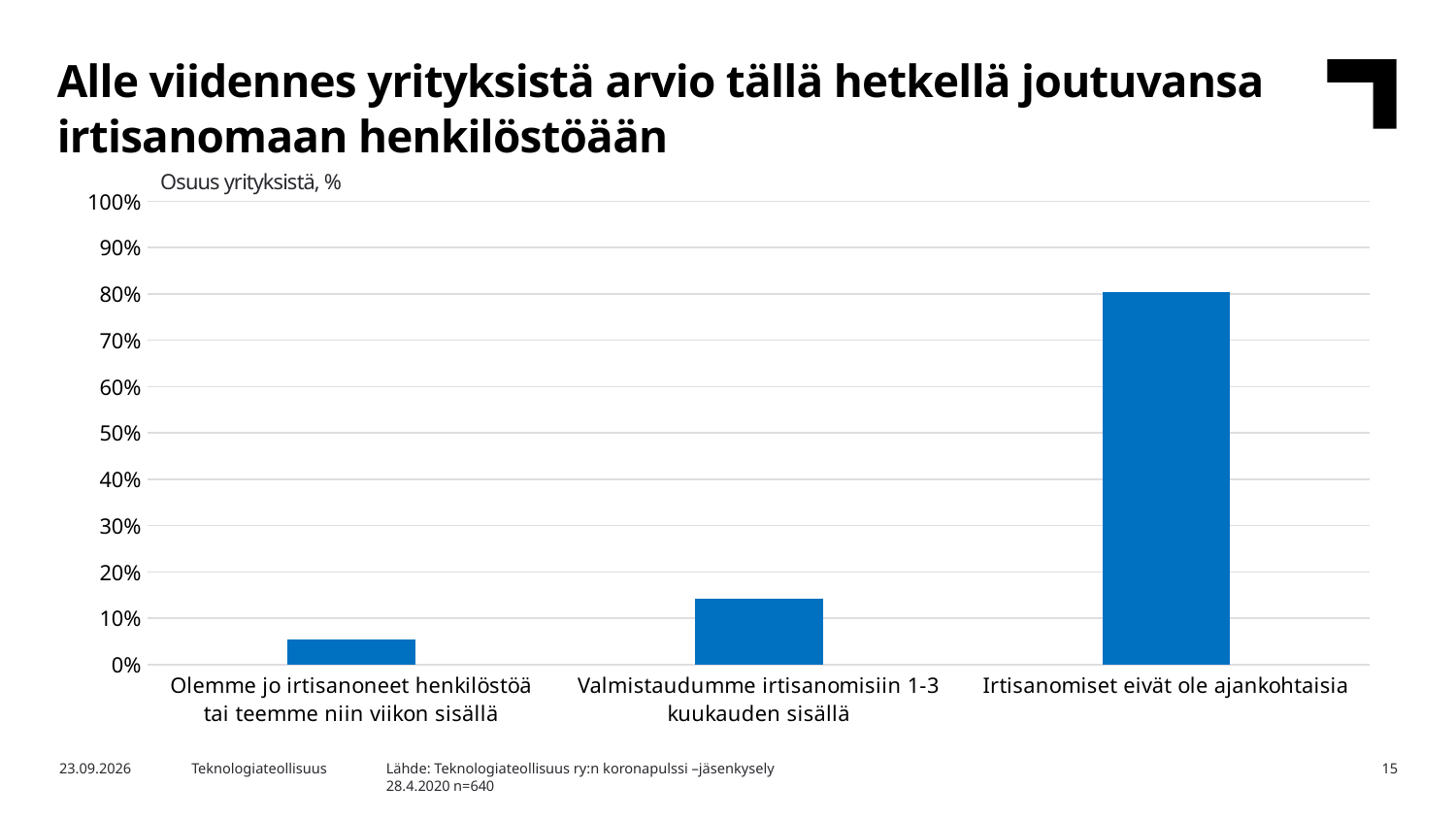
Which category has the highest value in the chart? Irtisanomiset eivät ole ajankohtaisia What is the label of the vertical axis of the chart? Osuus yrityksistä, % Is the value for 'Valmistaudumme irtisanomisiin 1-3 kuukauden sisällä' greater or less than 10%? greater What is the maximum value shown on the vertical axis of the chart? 100% How many categories are shown on the x axis of the chart? 3 What kind of chart is shown on the slide? bar chart Which category has the lowest value in the chart? Olemme jo irtisanoneet henkilöstöä tai teemme niin viikon sisällä Is the value for 'Valmistaudumme irtisanomisiin 1-3 kuukauden sisällä' greater or less than 20%? less Is the value for 'Irtisanomiset eivät ole ajankohtaisia' greater or less than 70%? greater Which is larger: the value for 'Valmistaudumme irtisanomisiin 1-3 kuukauden sisällä' or the value for 'Olemme jo irtisanoneet henkilöstöä tai teemme niin viikon sisällä'? Valmistaudumme irtisanomisiin 1-3 kuukauden sisällä